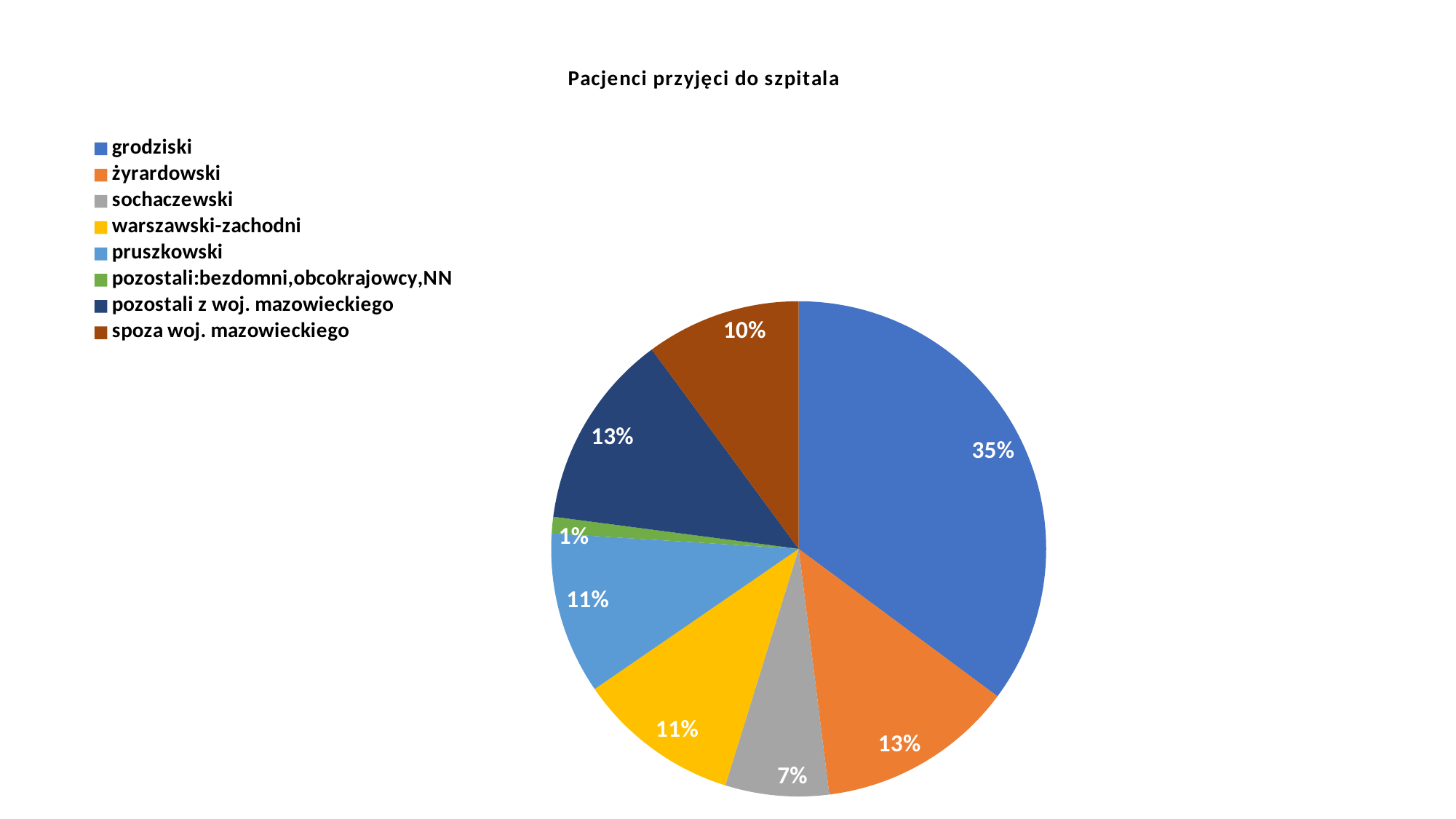
What colour is the slice for warszawski-zachodni? yellow Which category has the smallest slice of the pie? pozostali:bezdomni,obcokrajowcy,NN How many categories does the legend list? 8 What is the difference in percentage points between grodziski and żyrardowski? 22 Which category has the largest slice of the pie? grodziski What is the title of the chart? Pacjenci przyjęci do szpitala What share of the pie does the grodziski slice represent? 35% Which is larger, the slice for sochaczewski or the slice for pruszkowski? pruszkowski What percentage is shown for spoza woj. mazowieckiego? 10% What percentage is shown for sochaczewski? 7% What type of chart is shown on the slide? pie chart What percentage is shown for pozostali z woj. mazowieckiego? 13%